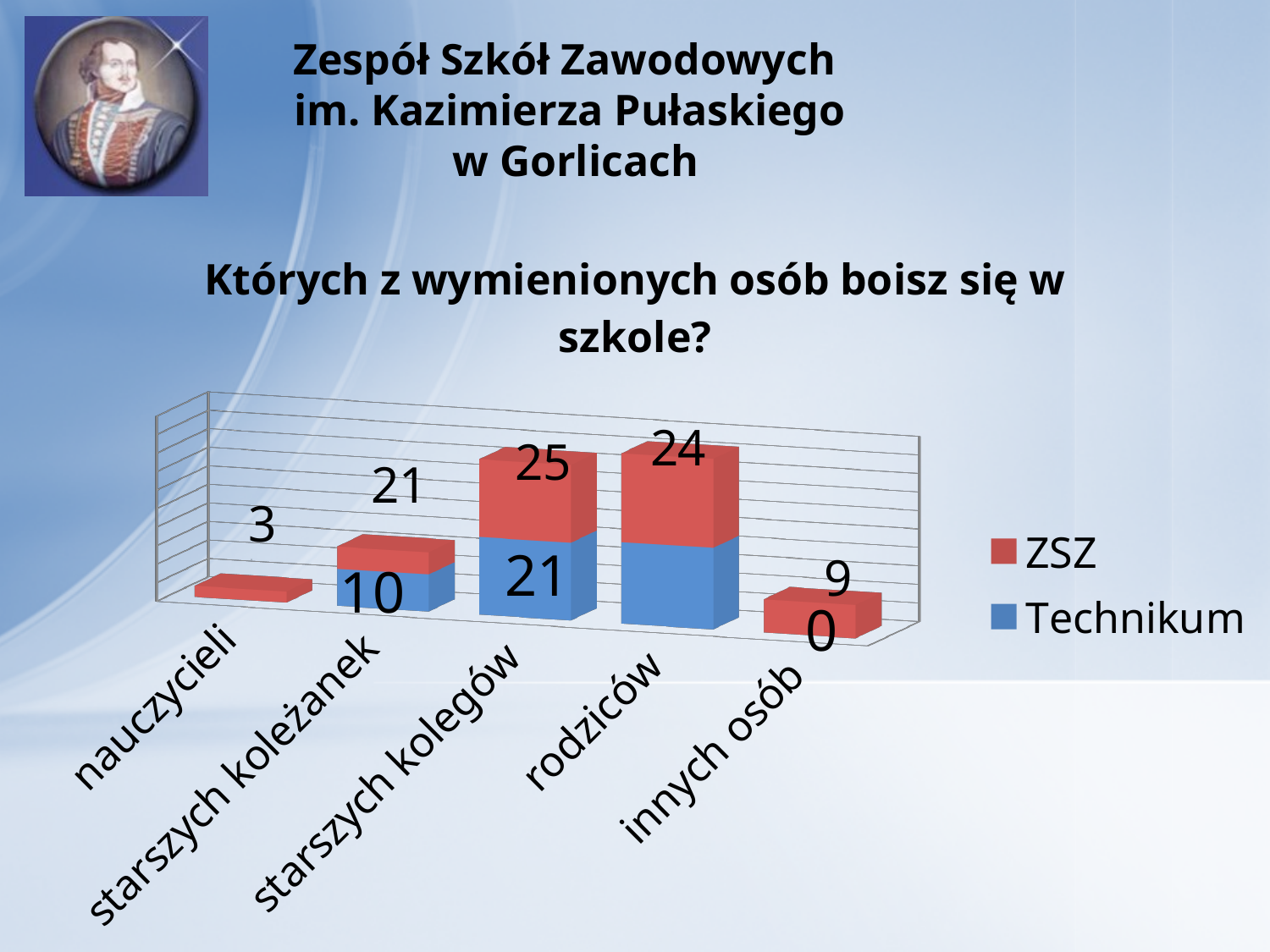
How many series does the legend list? 2 What is the ZSZ value for rodziców? 24 What is the total of the stacked bar for starszych koleżanek? 31 What is the difference between the ZSZ and Technikum values for starszych kolegów? 4 What is the Technikum value for innych osób? 0 What is the Technikum value for starszych koleżanek? 10 What kind of chart is shown on the slide? Stacked bar chart For starszych koleżanek, which series has the larger value, ZSZ or Technikum? ZSZ What is the ZSZ value for starszych kolegów? 25 Which category has the highest ZSZ value? starszych kolegów How many categories are shown on the x axis? 5 Which category has the lowest ZSZ value? nauczycieli